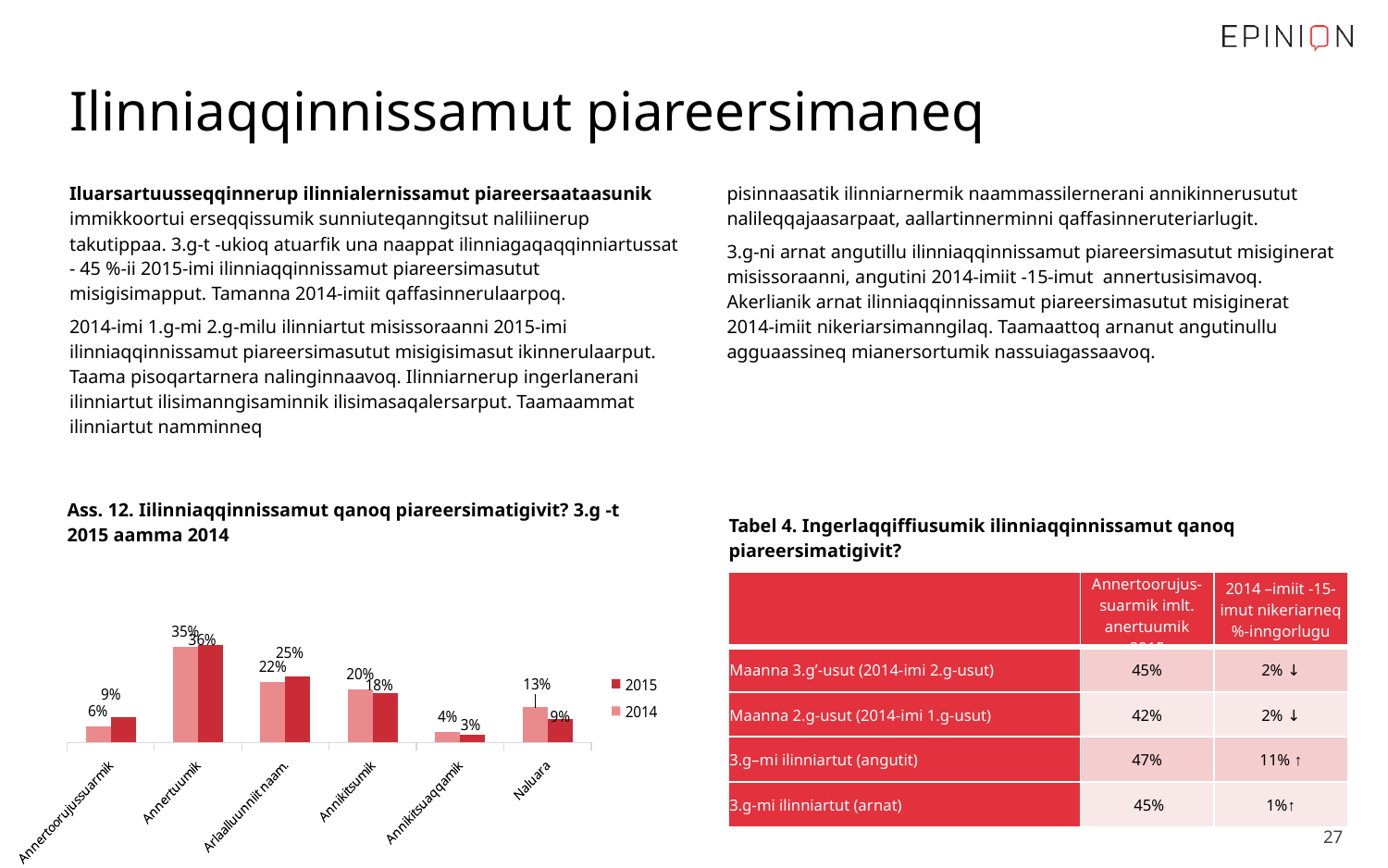
What type of chart is shown on the slide? bar chart Which category has the highest 2015 value? Annertuumik How many categories are shown on the x axis of the chart? 6 Which series is shown in the darker red colour in the chart legend? 2015 What is the 2015 value for Arlaalluunniit naam.? 25% Which category has the lowest 2014 value? Annikitsuaqqamik For Annertoorujussuarmik, which year has the larger value, 2014 or 2015? 2015 What is the 2014 value for Naluara? 13% What is the difference between the 2014 and 2015 values for Naluara? 4% How many series does the chart legend list? 2 What is the 2014 value for Annikitsumik? 20% What is the 2015 value for Annertuumik? 36%